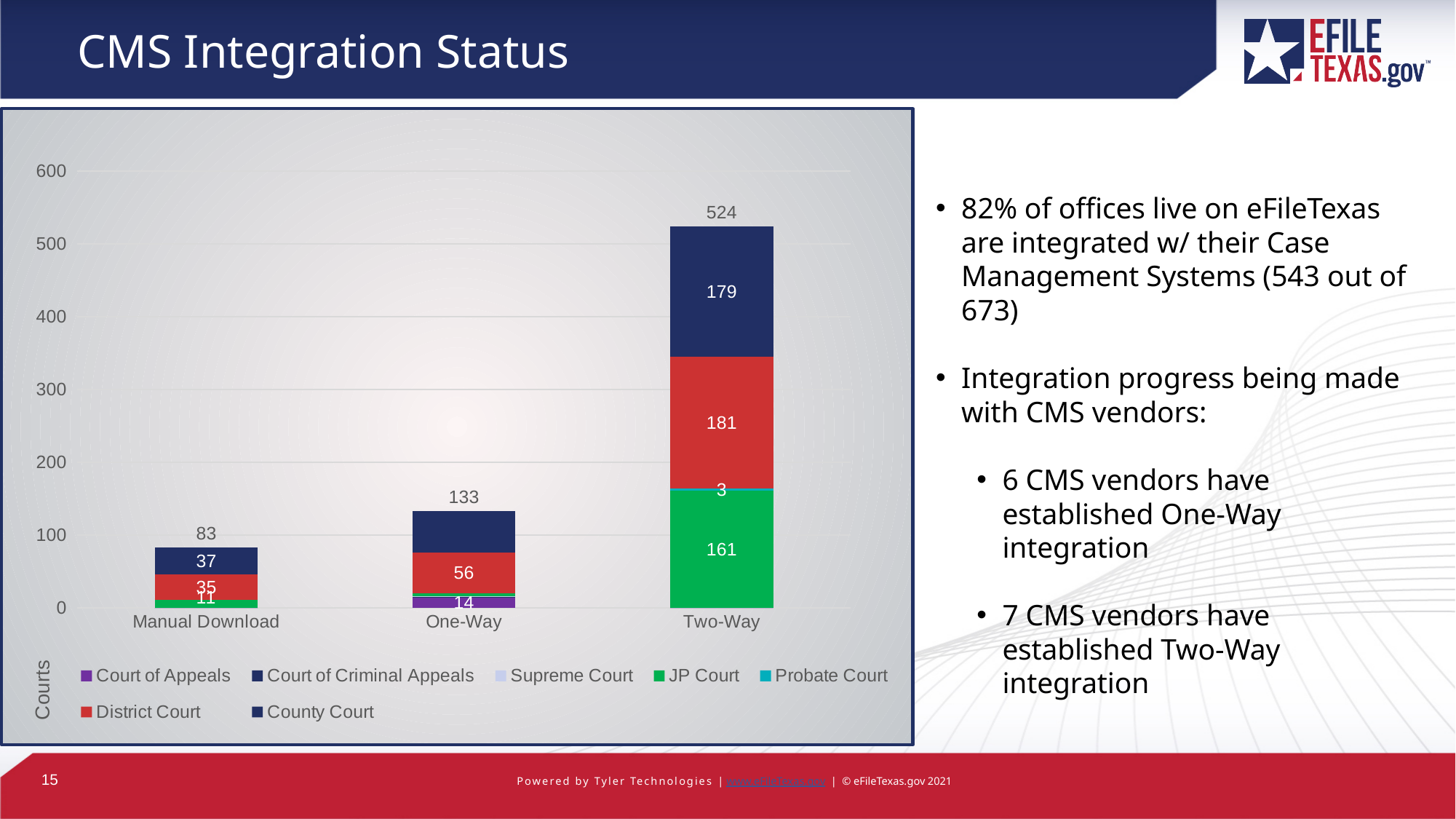
What is the total value shown above the One-Way bar? 133 What is the total value shown above the Two-Way bar? 524 How many categories are shown on the x axis? 3 What is the JP Court value for the Two-Way bar? 161 Which category has the lowest total number of courts? Manual Download What is the District Court value for the Manual Download bar? 35 How many series does the legend list? 7 What is the District Court value for the One-Way bar? 56 What is the total value shown above the Manual Download bar? 83 Is the District Court value larger for Two-Way or for One-Way? Two-Way Which category has the highest total number of courts? Two-Way What is the difference between the Two-Way total and the One-Way total? 391